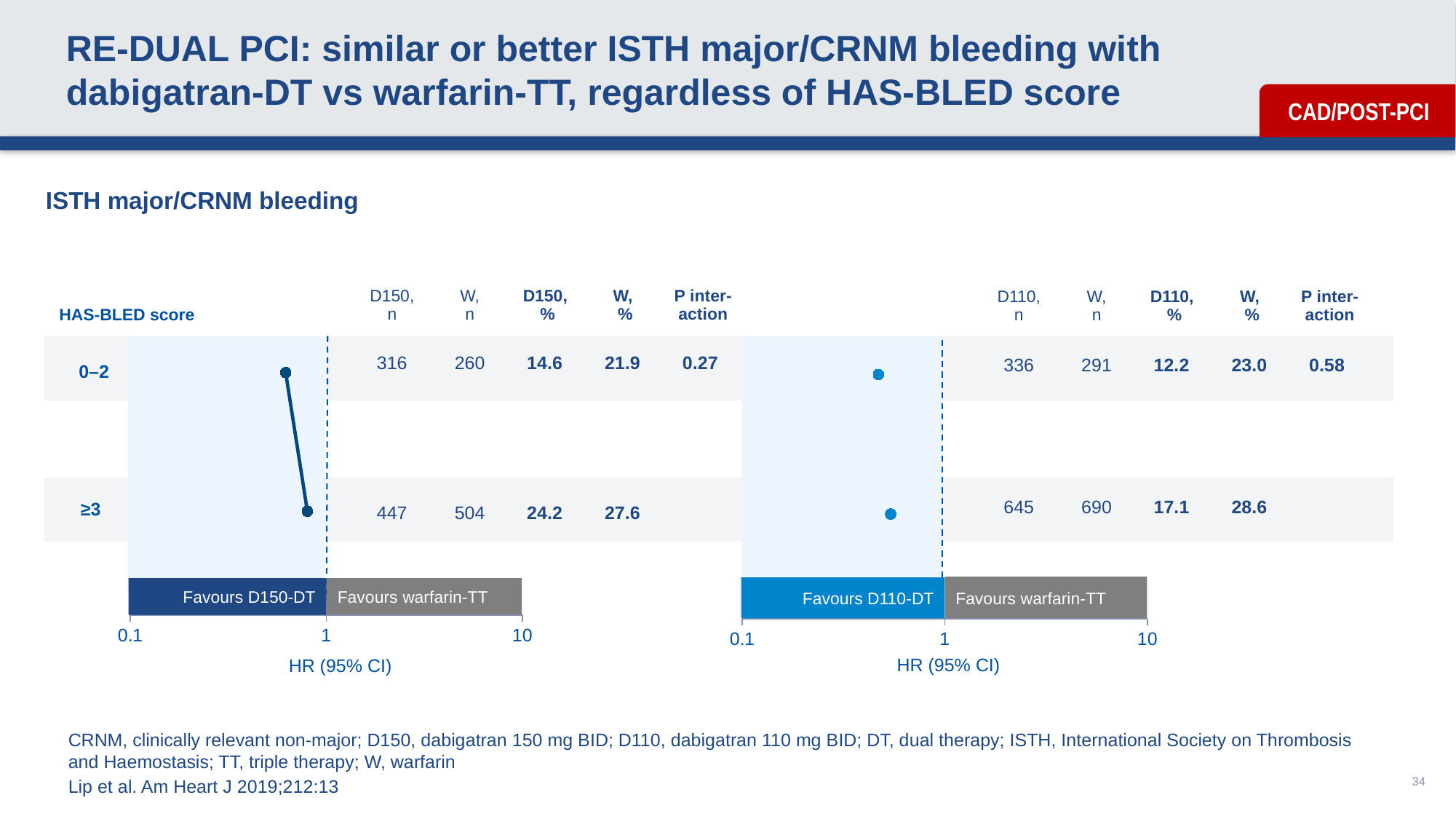
In the left chart (D150-DT vs warfarin-TT), what is the P value for interaction? 0.27 How many HAS-BLED score subgroups are plotted in each chart? 2 In the left chart, what is the difference between the warfarin and D150 bleeding rates (%) in the HAS-BLED 0–2 subgroup? 7.3 In the left chart (D150-DT vs warfarin-TT), what is the warfarin bleeding rate (%) in the HAS-BLED ≥3 subgroup? 27.6 In the right chart, which group has the higher bleeding rate in the HAS-BLED 0–2 subgroup, D110 or warfarin? warfarin In the right chart (D110-DT vs warfarin-TT), what is the warfarin bleeding rate (%) in the HAS-BLED 0–2 subgroup? 23.0 What kind of chart is used on this slide to display the hazard ratios? forest plot In the right chart (D110-DT vs warfarin-TT), what is the P value for interaction? 0.58 In the right chart (D110-DT vs warfarin-TT), how many patients (n) were in the D110 group with HAS-BLED ≥3? 645 In the right chart, what is the difference between the warfarin and D110 bleeding rates (%) in the HAS-BLED ≥3 subgroup? 11.5 In the left chart (D150-DT vs warfarin-TT), what is the ISTH major/CRNM bleeding rate (%) for D150 in the HAS-BLED 0–2 subgroup? 14.6 In the left chart, is the hazard ratio point for the HAS-BLED ≥3 subgroup greater or less than 1? less